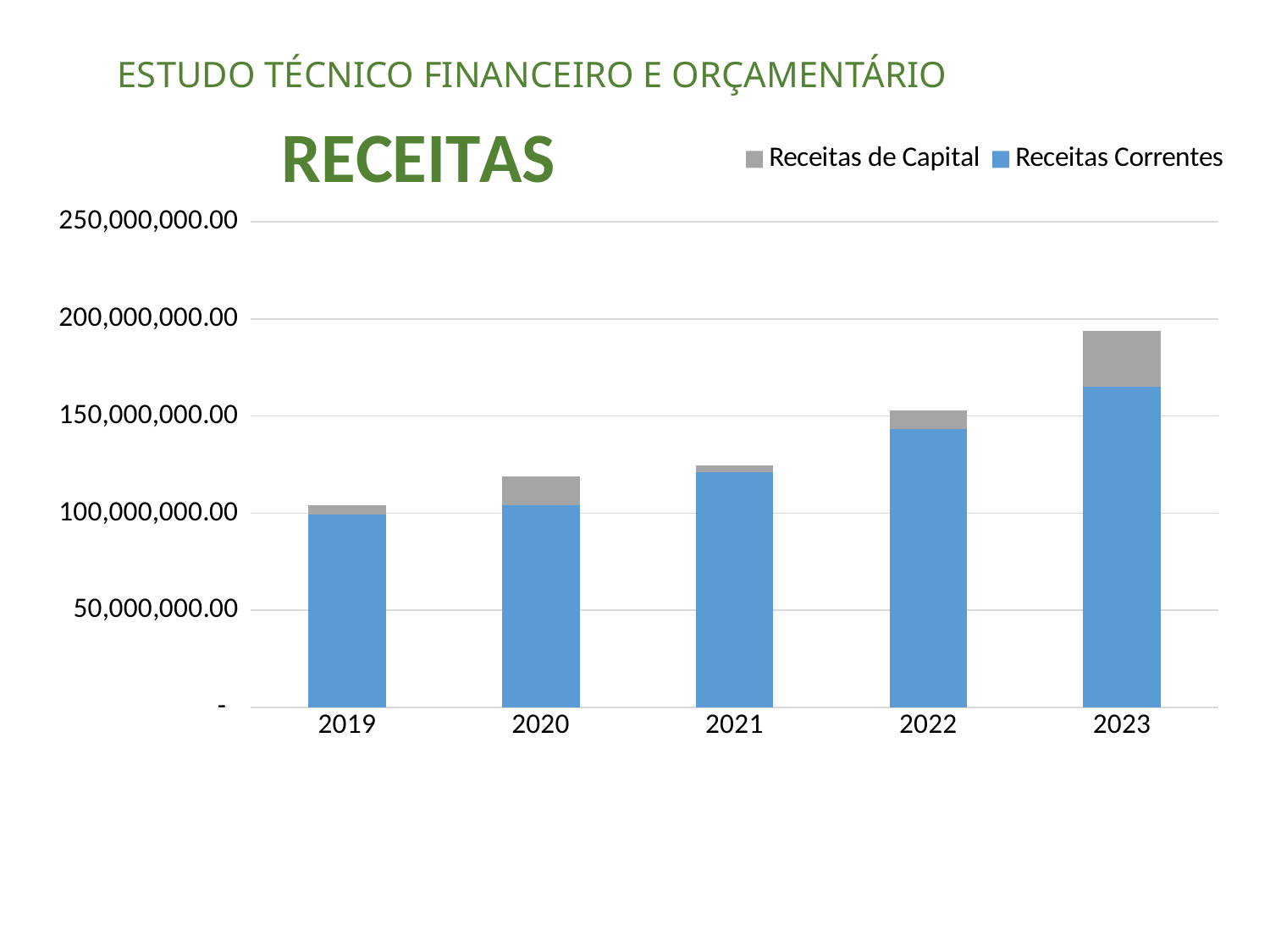
Is the value for Receitas Correntes in 2021 greater or less than 100,000,000.00? greater Is the total bar for 2023 greater or less than 200,000,000.00? less Is the total bar for 2023 greater or less than 150,000,000.00? greater How many series does the legend list? 2 Which is larger, the total bar for 2022 or the total bar for 2021? 2022 Which year has the lowest total bar? 2019 Which series is shown in gray in the legend? Receitas de Capital How many years are shown on the x axis? 5 What kind of chart is shown on the slide? stacked bar chart Which year has the highest total bar? 2023 Do the total bars rise or fall from 2019 to 2023? rise